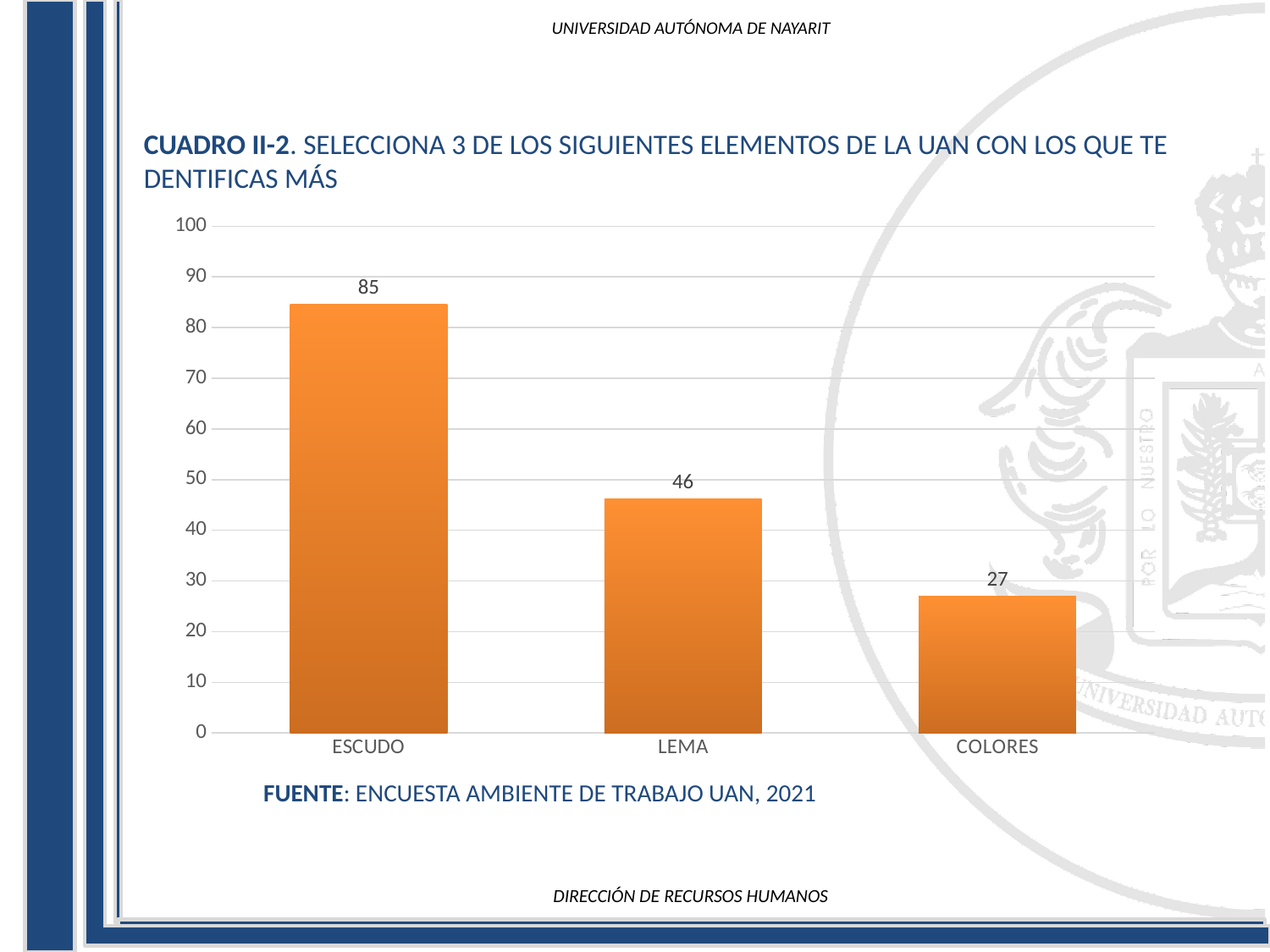
Which category has the lowest value? COLORES What is the difference between the values for ESCUDO and LEMA? 39 Do the values rise or fall from left to right along the x axis? fall What is the value for LEMA? 46 What is the value for ESCUDO? 85 Is the value for ESCUDO greater or less than 80? greater What is the difference between the values for LEMA and COLORES? 19 What is the value for COLORES? 27 How many categories are shown on the x axis? 3 Which is larger, the value for LEMA or the value for COLORES? LEMA What kind of chart is shown on the slide? bar chart Which category has the highest value? ESCUDO